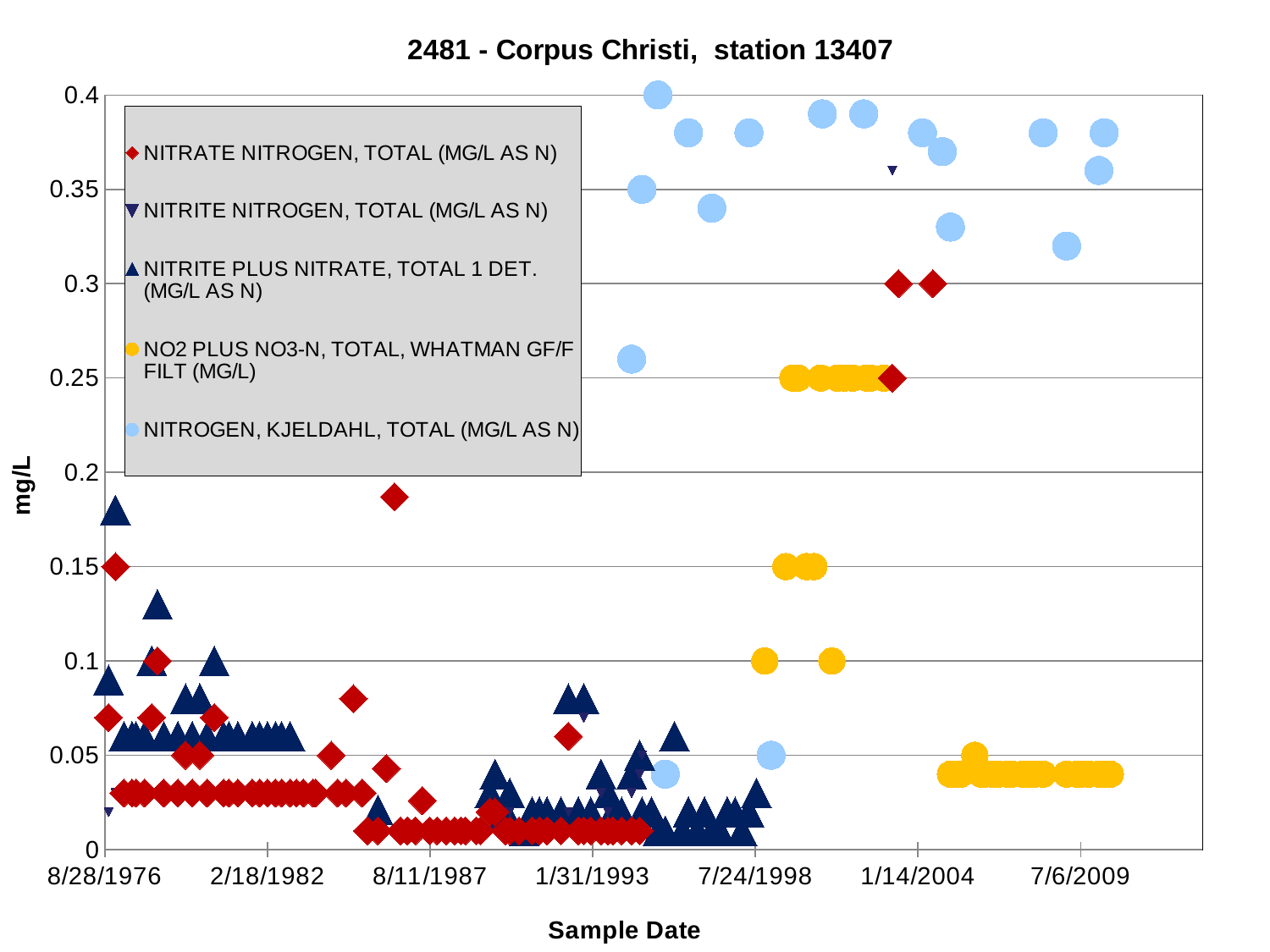
Is the earliest NITRITE PLUS NITRATE, TOTAL 1 DET. value (at 8/28/1976) greater or less than 0.15? greater What is the title of the chart? 2481 - Corpus Christi, station 13407 What kind of chart is shown on the slide? scatter chart Are the NITROGEN, KJELDAHL, TOTAL values plotted after 1/14/2004 greater or less than 0.3? greater Which series has the highest plotted values on the chart? NITROGEN, KJELDAHL, TOTAL (MG/L AS N) What is the label of the y axis? mg/L Around 2000, which series has larger values: NITROGEN, KJELDAHL, TOTAL or NO2 PLUS NO3-N, TOTAL, WHATMAN GF/F FILT? NITROGEN, KJELDAHL, TOTAL (MG/L AS N) How many series does the legend list? 5